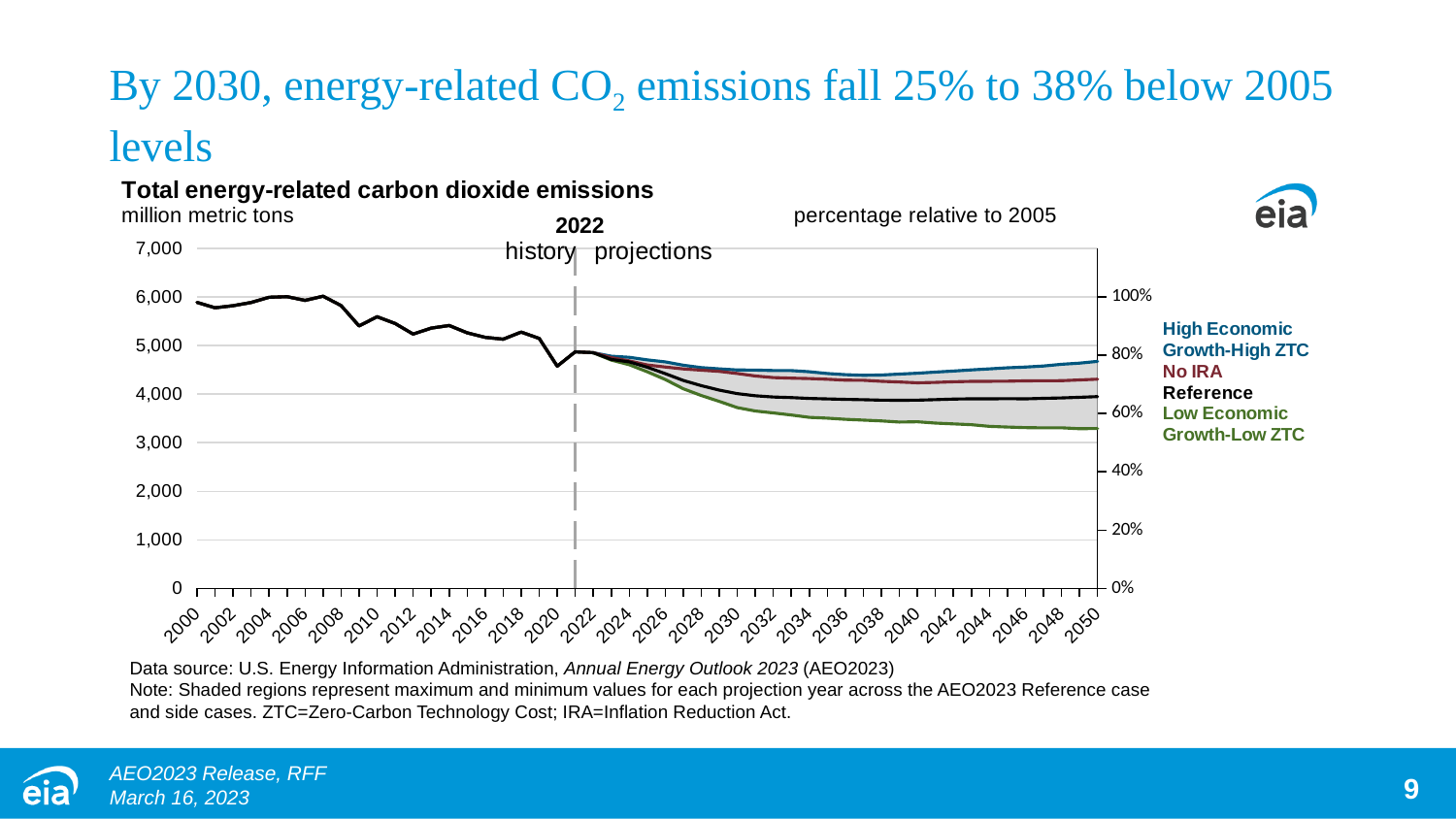
Do total energy-related carbon dioxide emissions rise or fall between 2008 and 2022? fall Is the value for the High Economic Growth-High ZTC series in 2050 greater or less than 4,000 million metric tons? greater Which year marks the boundary between history and projections on the chart? 2022 How many projection series are labelled in the legend of the chart? 4 In 2050, which is higher: the No IRA series or the Low Economic Growth-Low ZTC series? No IRA What kind of chart is shown on the slide? line chart Is the value for the Low Economic Growth-Low ZTC series in 2050 greater or less than 4,000 million metric tons? less Which series has the highest emissions in 2050? High Economic Growth-High ZTC What does the right-hand axis of the chart measure? percentage relative to 2005 Which series has the lowest emissions in 2050? Low Economic Growth-Low ZTC Is the value for emissions in 2007 greater or less than 5,000 million metric tons? greater Does the Low Economic Growth-Low ZTC series rise or fall from 2022 to 2050? fall